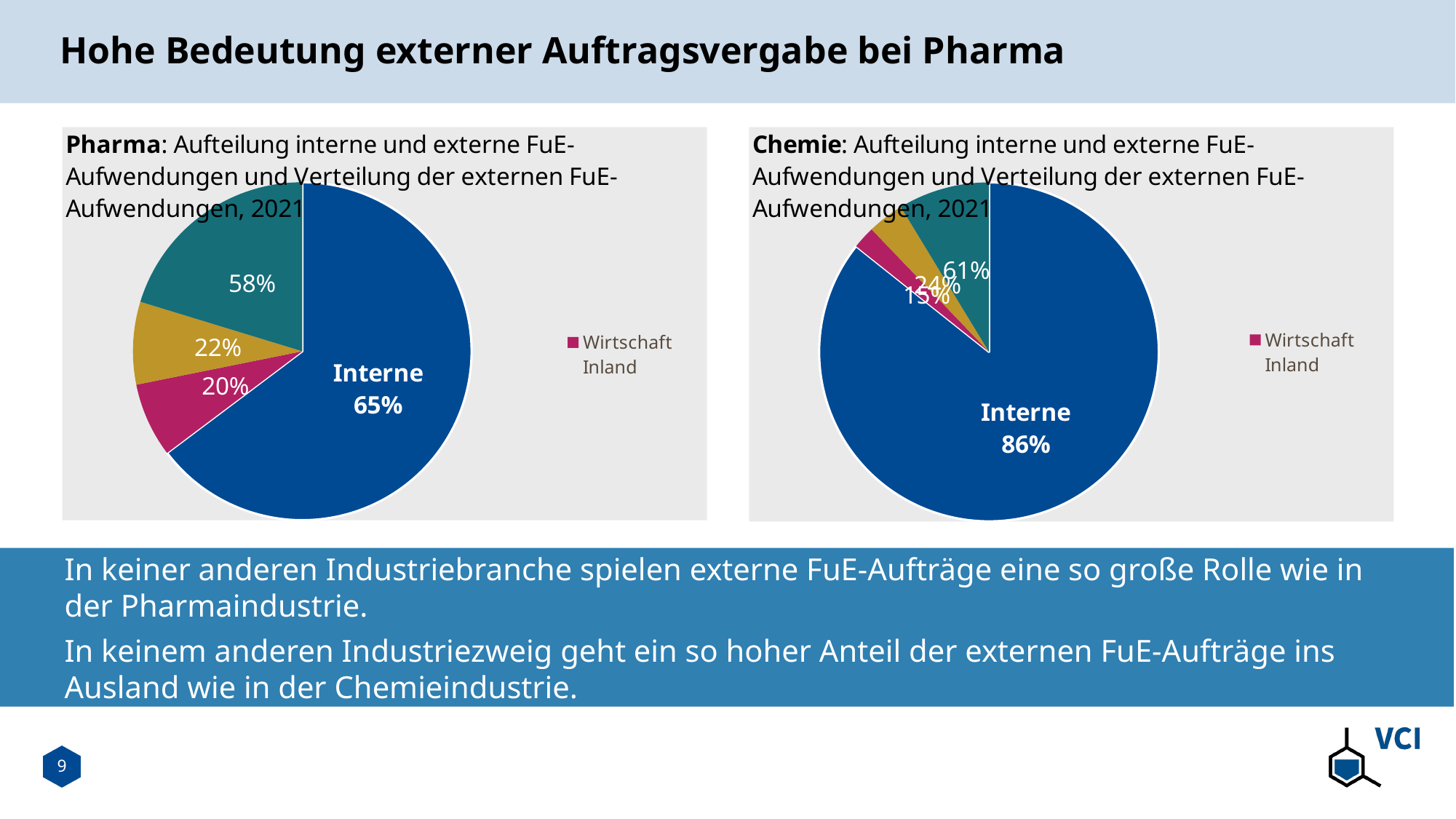
In the Pharma chart, what value is shown for the Wirtschaft Inland slice? 20% What is the difference in percentage points between the Interne share in the Chemie chart (86%) and in the Pharma chart (65%)? 21 percentage points In the Pharma chart, what is the largest of the three external slices? 58% What kind of chart is the Pharma chart? pie chart How many slices does the Pharma pie chart have? 4 In the Pharma chart, which slice is larger, the one labelled 22% or the one labelled 58%? 58% Which legend entry is shown next to the Chemie chart? Wirtschaft Inland In the Chemie chart, what share is labelled Interne? 86% In the Pharma chart, what share is labelled Interne? 65% Which chart has the larger Interne share, Pharma or Chemie? Chemie In the Pharma chart, what is the smallest of the three external slices? 20% In the Chemie chart, what is the largest of the three external slices? 61%